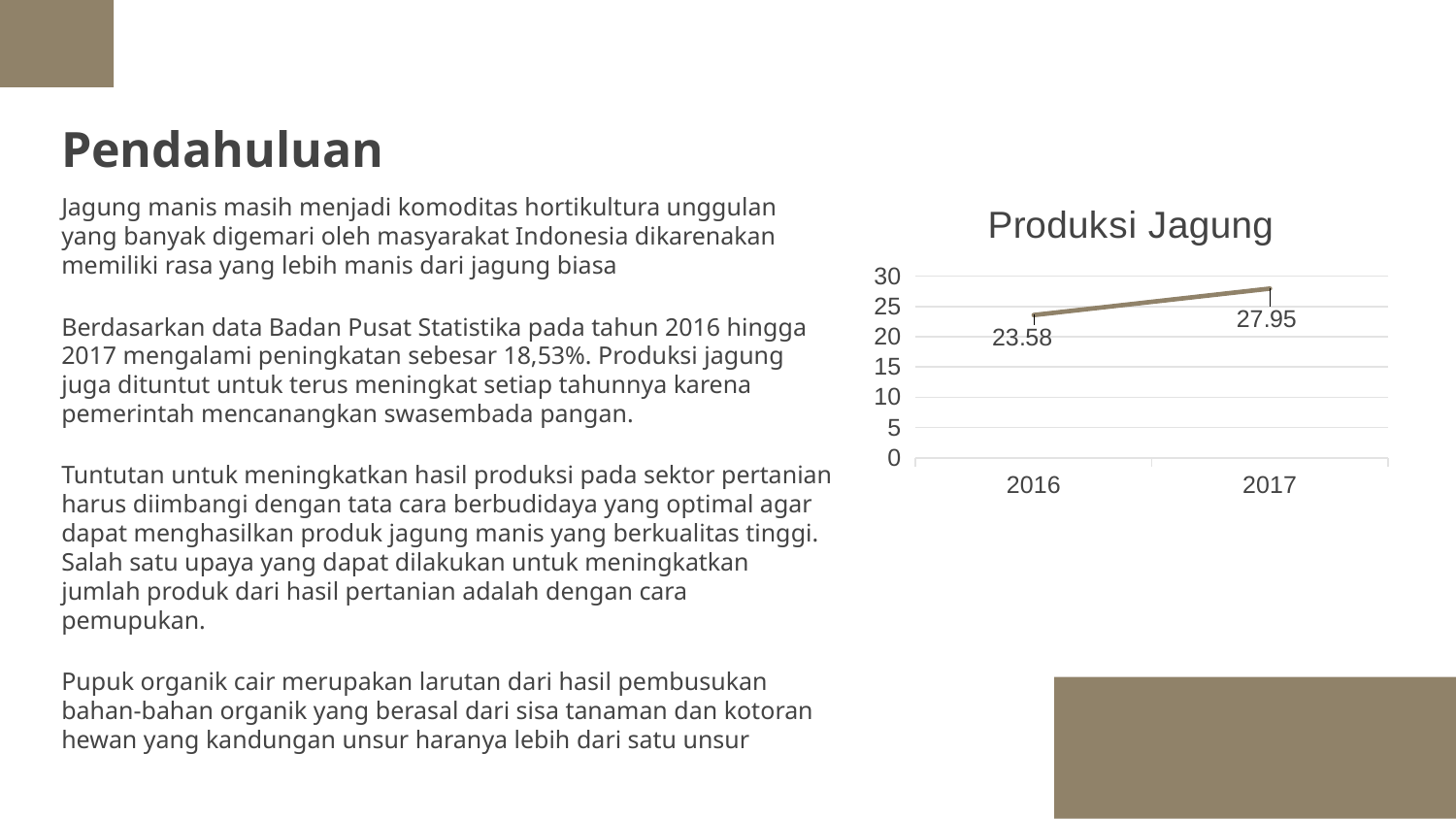
What is the difference between the 2017 and 2016 values in the Produksi Jagung chart? 4.37 Do the values in the Produksi Jagung chart rise or fall from 2016 to 2017? rise What is the value for 2017 in the Produksi Jagung chart? 27.95 What is the value for 2016 in the Produksi Jagung chart? 23.58 Is the value for 2017 in the Produksi Jagung chart greater or less than 25? greater Is the value for 2016 in the Produksi Jagung chart greater or less than 25? less Which year has the highest value in the Produksi Jagung chart? 2017 What kind of chart is the Produksi Jagung chart? line chart Which is larger in the Produksi Jagung chart, the value for 2016 or 2017? 2017 Which year has the lowest value in the Produksi Jagung chart? 2016 What is the title of the chart on the slide? Produksi Jagung How many data points are plotted in the Produksi Jagung chart? 2